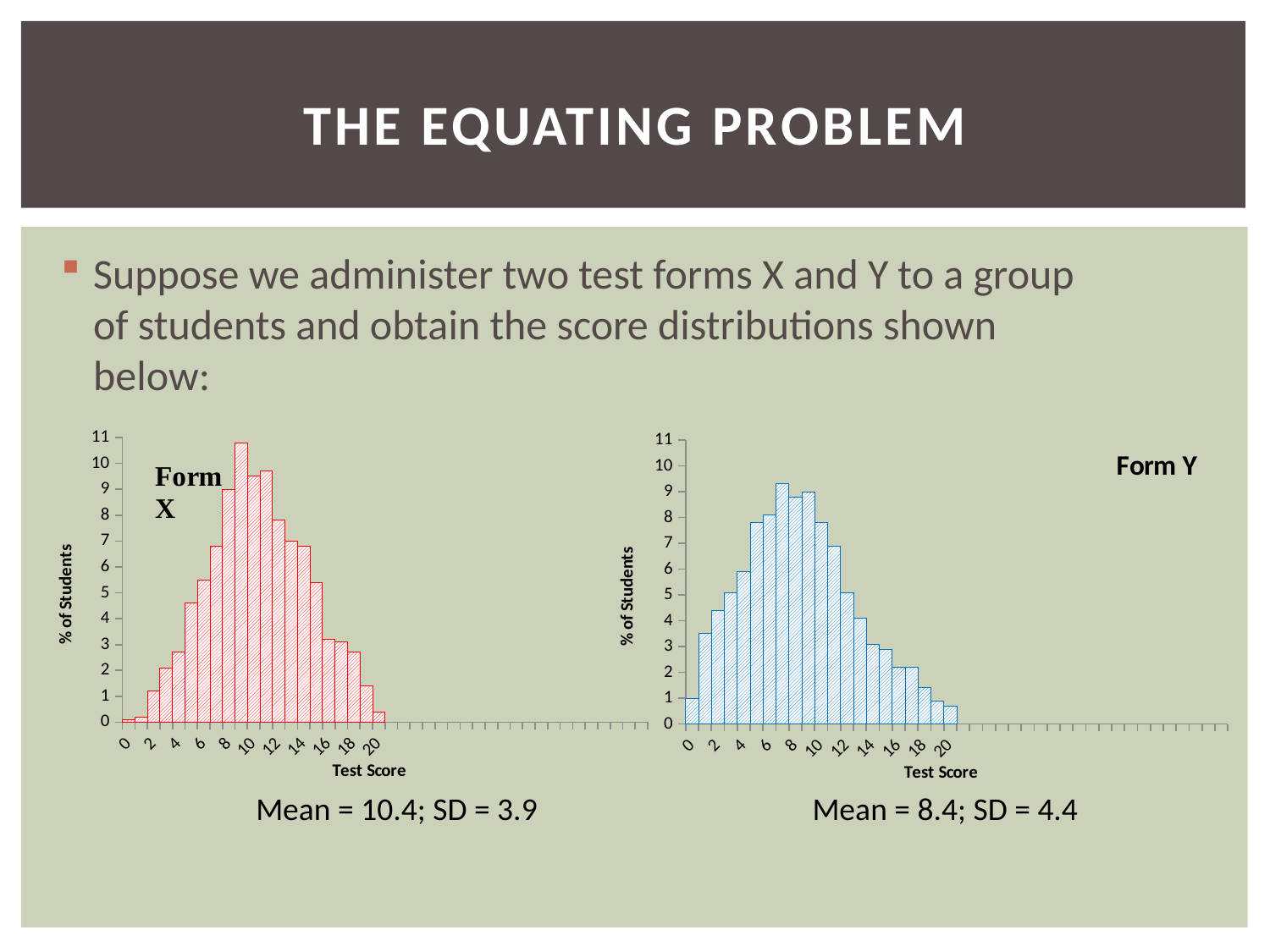
In the Form Y chart, which has a higher percentage of students: test score 1 or test score 12? test score 12 In the Form X chart, is the value for test score 5 greater or less than 4? greater How many test score bars are plotted in the Form X chart? 21 What kind of chart is the Form X chart on the left? bar chart In the Form Y chart, is the value for test score 0 greater or less than 2? less In the Form X chart, is the value for test score 15 greater or less than 6? less What is the y-axis title of the Form Y chart? % of Students In the Form X chart, which has a higher percentage of students: test score 8 or test score 16? test score 8 In the Form X chart, which test score has the highest percentage of students? 9 In the Form Y chart, which test score has the highest percentage of students? 7